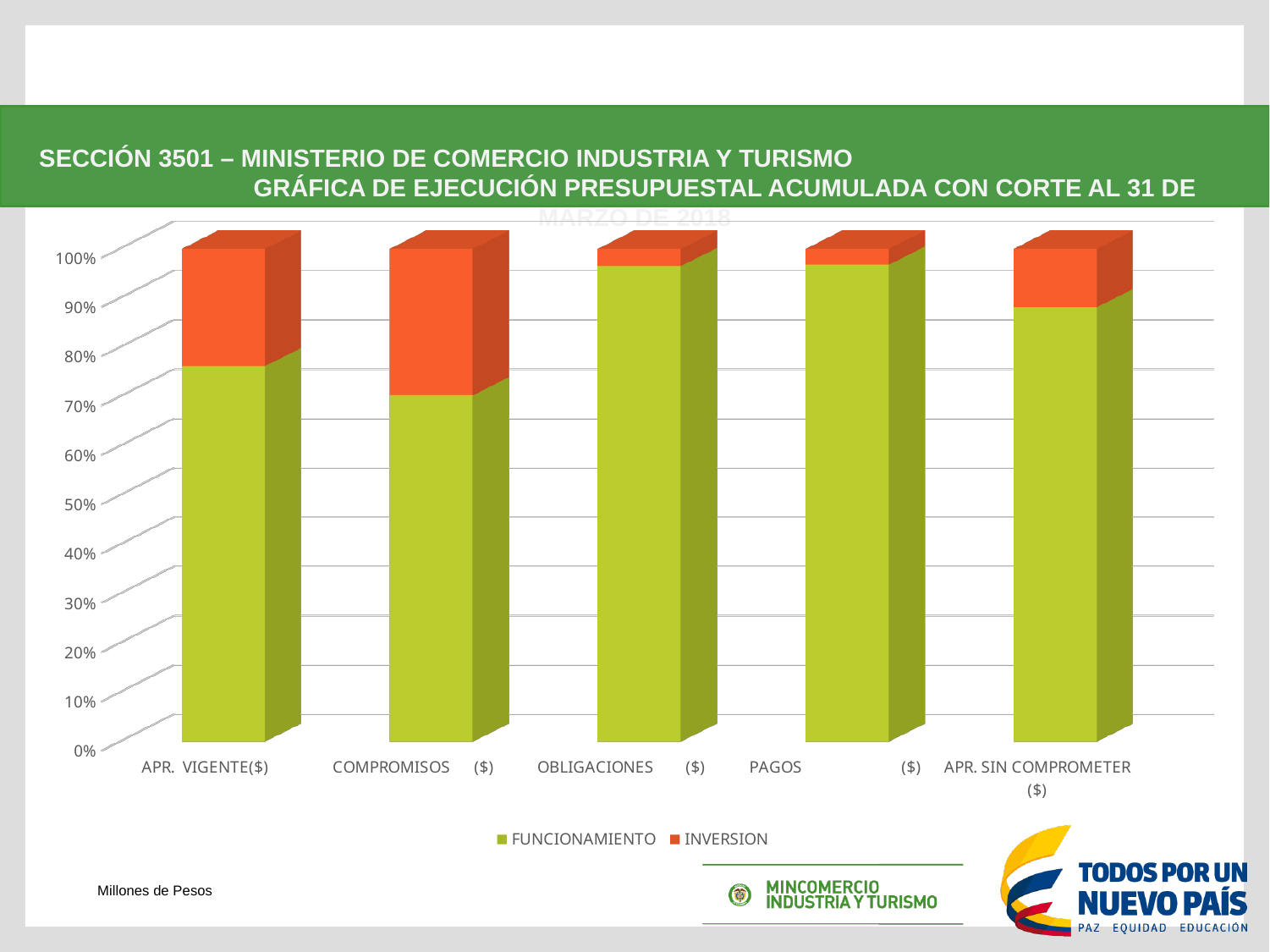
Which category has the largest INVERSION share? COMPROMISOS ($) How many categories are shown along the x axis of the chart? 5 Is the INVERSION share for COMPROMISOS ($) greater or less than 20%? greater What colour represents the INVERSION series in the chart? Orange What kind of chart is shown on the slide? Stacked bar chart Is the FUNCIONAMIENTO share for APR. SIN COMPROMETER ($) greater or less than 80%? greater Which category has the lowest FUNCIONAMIENTO share? COMPROMISOS ($) Is the FUNCIONAMIENTO share for APR. VIGENTE($) greater or less than 60%? greater Which two series are listed in the chart's legend? FUNCIONAMIENTO and INVERSION How many series does the chart's legend list? 2